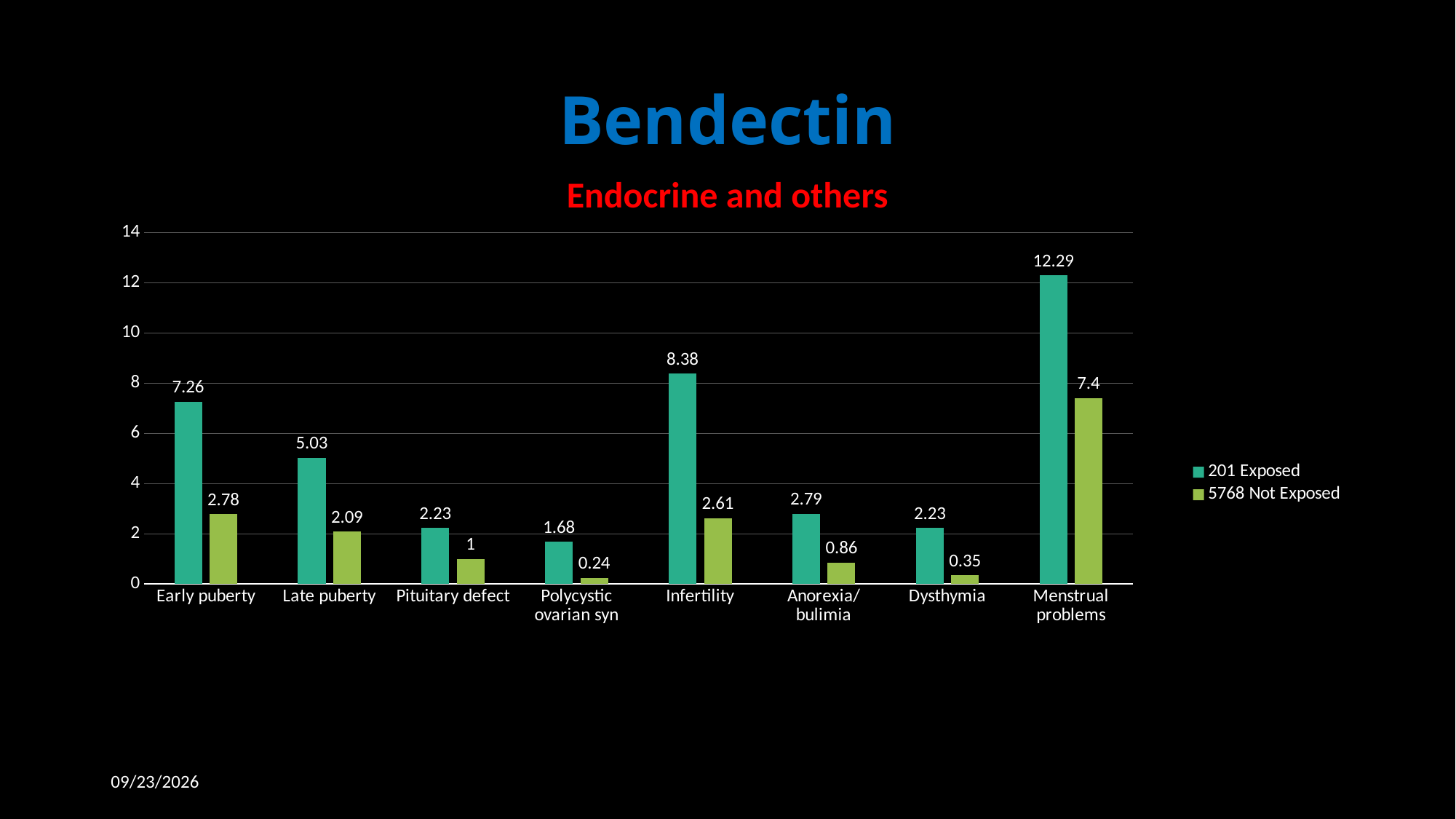
Which is larger for Late puberty: the 201 Exposed value or the 5768 Not Exposed value? 201 Exposed What is the difference between the 201 Exposed and 5768 Not Exposed values for Early puberty? 4.48 Which category has the lowest value in the 5768 Not Exposed series? Polycystic ovarian syn How many categories are shown on the x axis? 8 What is the value for Menstrual problems in the 5768 Not Exposed series? 7.4 Is the 201 Exposed value for Menstrual problems greater or less than 12? greater What is the value for Polycystic ovarian syn in the 5768 Not Exposed series? 0.24 What is the value for Infertility in the 201 Exposed series? 8.38 How many series does the legend list? 2 What is the subtitle shown in red above the chart? Endocrine and others What kind of chart is shown on the slide? Bar chart Which category has the highest value in the 201 Exposed series? Menstrual problems